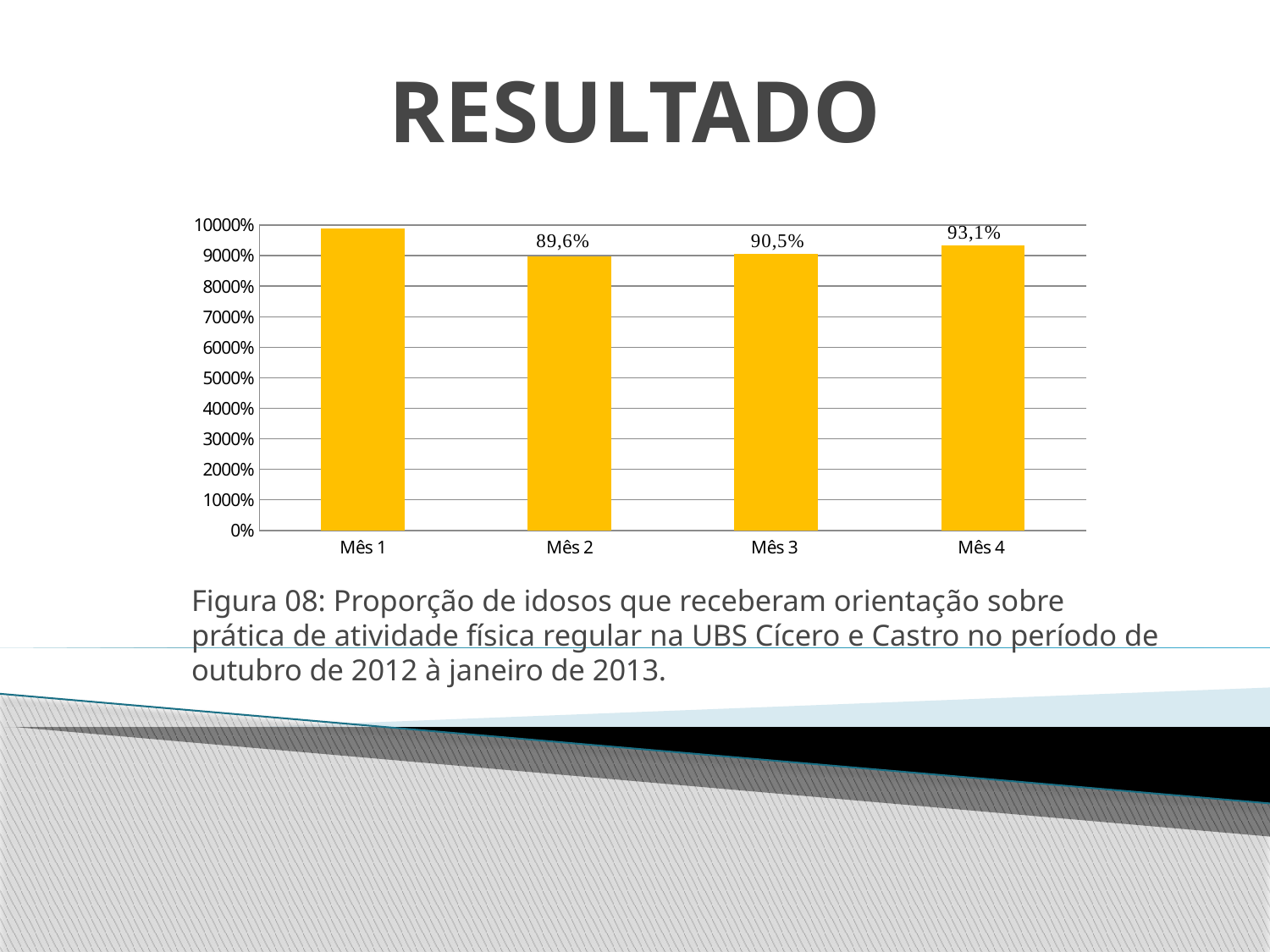
Which month has the tallest bar? Mês 1 What is the value shown for Mês 3? 90,5% What is the value shown for Mês 2? 89,6% What kind of chart is shown on the slide? Bar chart What is the value shown for Mês 4? 93,1% Which month has the lowest value? Mês 2 Is the bar for Mês 1 greater or less than 9000% on the axis? greater What is the difference between the values for Mês 4 and Mês 2? 3,5% Which is larger, the value for Mês 3 or the value for Mês 2? Mês 3 How many months are shown on the x axis? 4 What colour are the bars in the chart? Yellow Do the labelled values rise or fall from Mês 2 to Mês 4? Rise